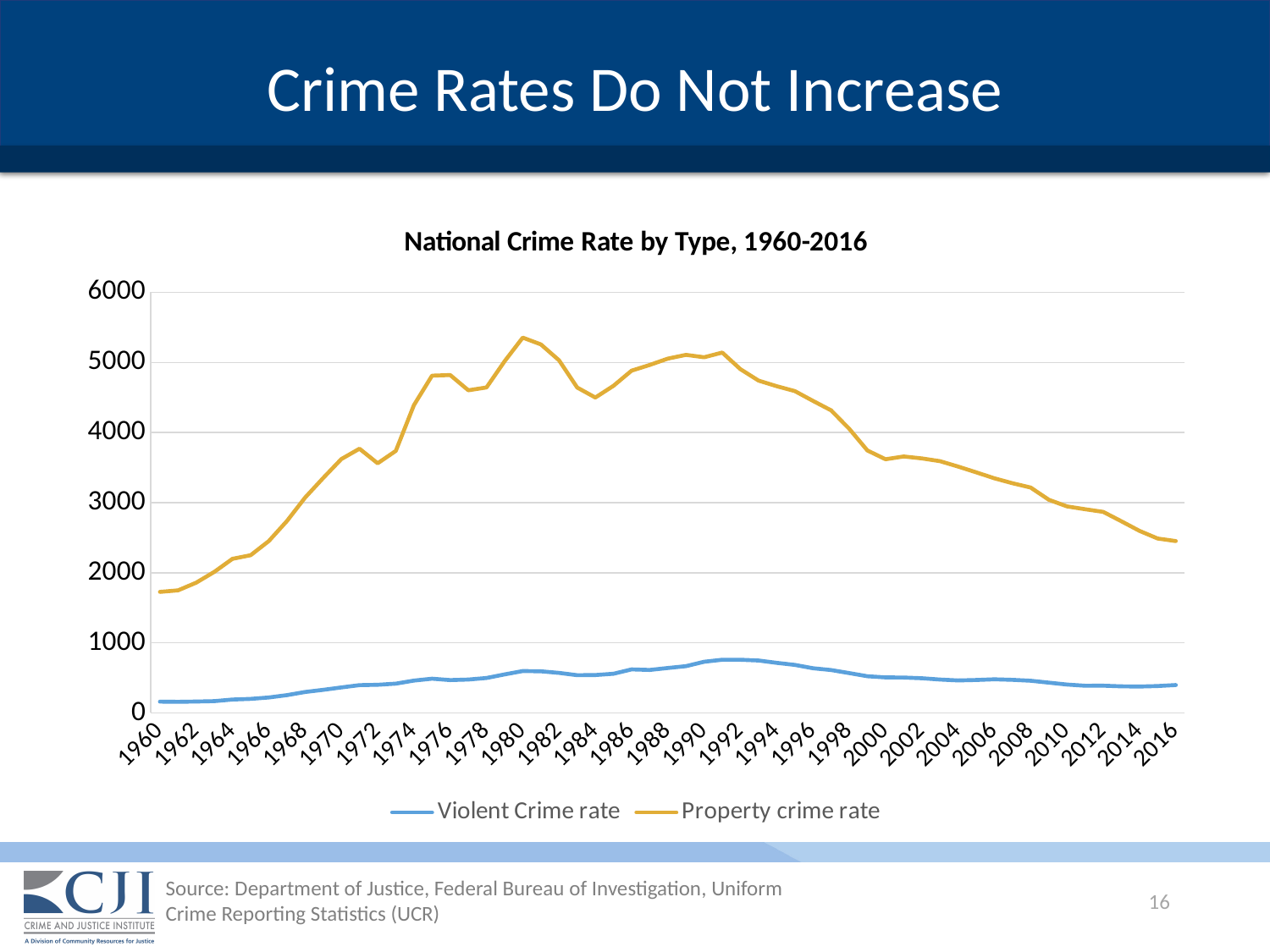
Does the Property crime rate rise or fall from 1992 to 2016? fall What kind of chart is shown on the slide? line chart Is the Property crime rate in 2000 greater or less than 3000? greater What is the title of the chart? National Crime Rate by Type, 1960-2016 Is the Property crime rate in 1980 greater or less than 5000? greater Is the Property crime rate in 1960 greater or less than 2000? less How many series does the legend list? 2 Does the Violent Crime rate rise or fall from 1960 to 1991? rise Which series is drawn in blue? Violent Crime rate In 1990, which is larger: the Violent Crime rate or the Property crime rate? Property crime rate